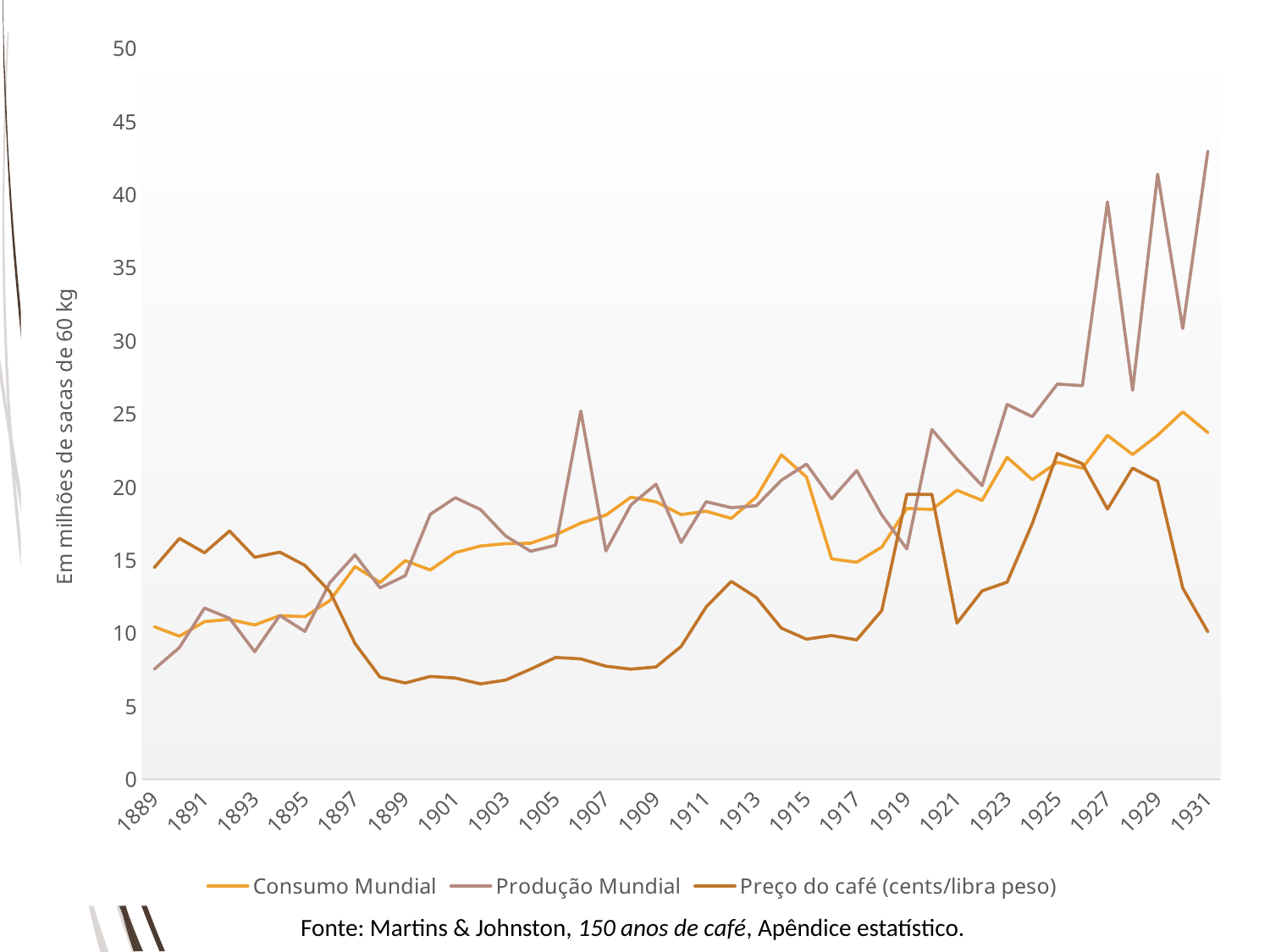
What kind of chart is shown on the slide? line chart Is the value for Produção Mundial in 1931 greater or less than 40? greater Which series is listed third in the legend? Preço do café (cents/libra peso) In 1931, which is larger: Produção Mundial or Consumo Mundial? Produção Mundial Is the value for Consumo Mundial in 1889 greater or less than 15? less Does Consumo Mundial generally rise or fall from 1889 to 1931? rise Is the value for Preço do café in 1921 greater or less than 15? less In 1889, which is larger: Preço do café or Consumo Mundial? Preço do café In which year does Produção Mundial reach its highest value? 1931 What is the title of the vertical axis? Em milhões de sacas de 60 kg How many series does the legend list? 3